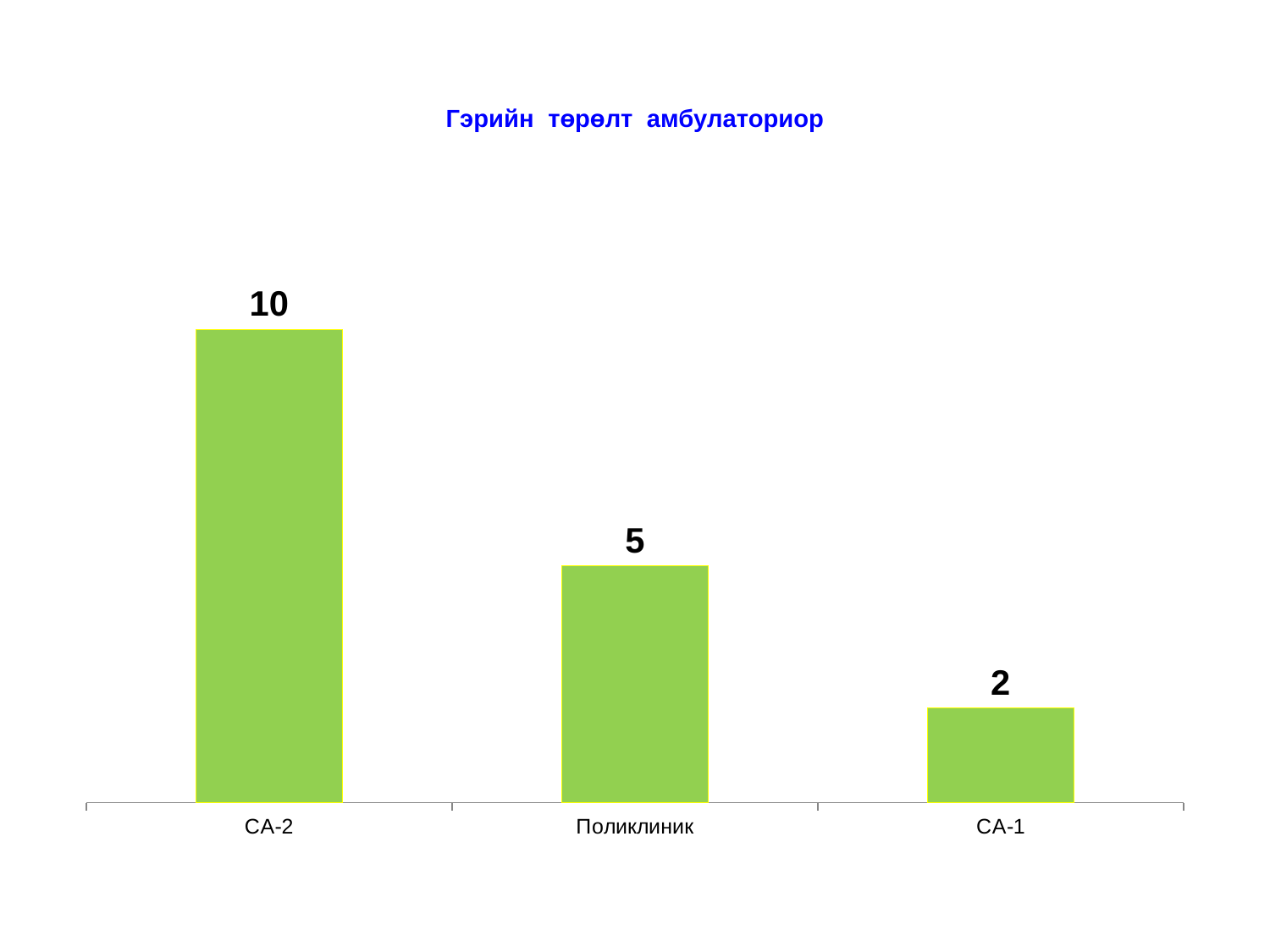
What is the value for СА-1? 2 Do the values rise or fall from left to right along the x axis? Fall Which category has the lowest value? СА-1 What is the value for СА-2? 10 What kind of chart is shown on the slide? Bar chart Which is larger, the value for Поликлиник or the value for СА-1? Поликлиник What is the difference between the values for Поликлиник and СА-1? 3 What is the value for Поликлиник? 5 What is the title of the chart? Гэрийн төрөлт амбулаториор How many categories are shown on the chart? 3 What is the difference between the values for СА-2 and Поликлиник? 5 Which category has the highest value? СА-2